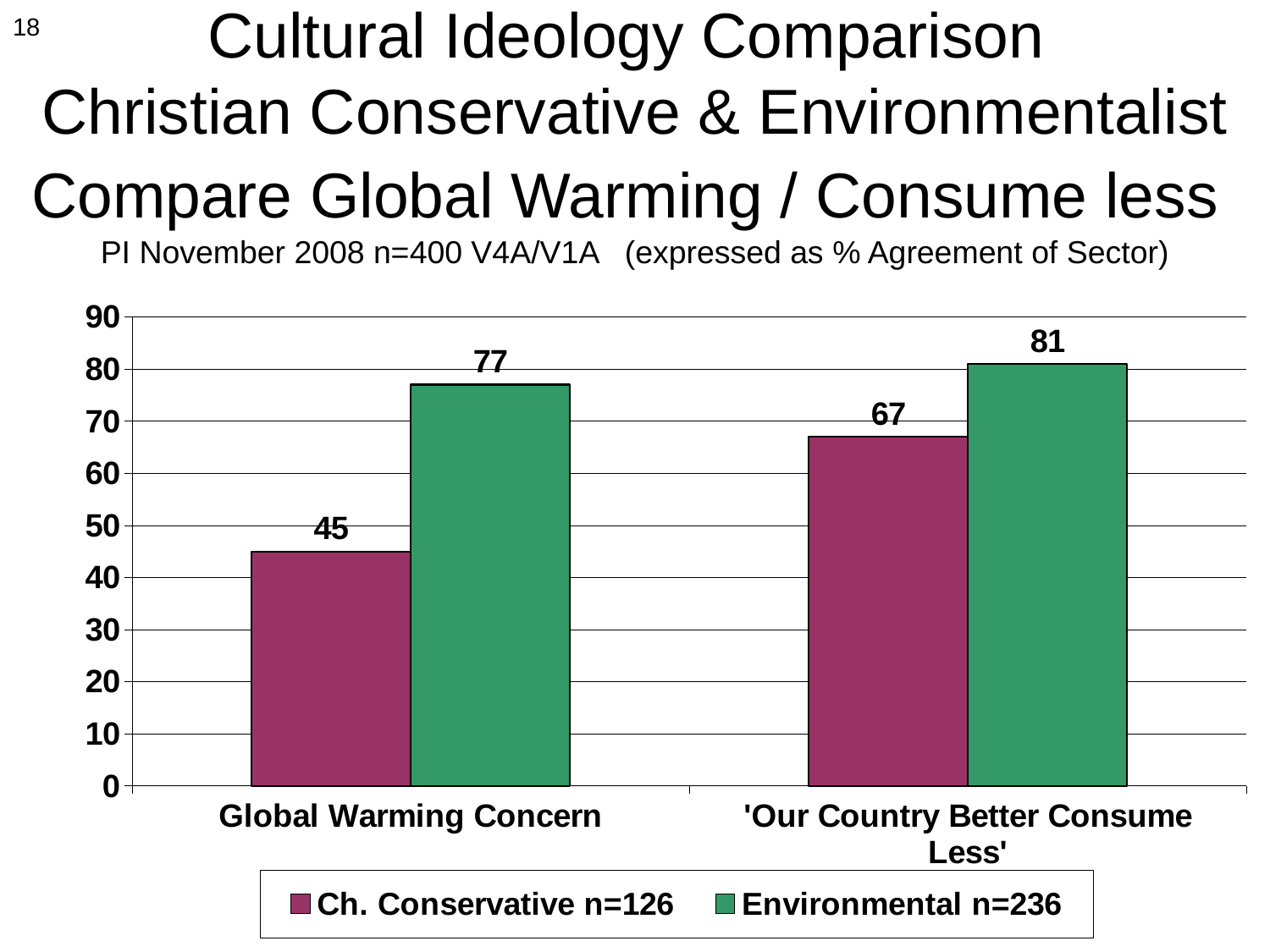
How many series does the legend list? 2 What is the value for Environmental n=236 on Global Warming Concern? 77 What is the value for Ch. Conservative n=126 on Global Warming Concern? 45 Which category has the highest value for the Environmental n=236 series? 'Our Country Better Consume Less' What is the difference between the Environmental n=236 and Ch. Conservative n=126 values on 'Our Country Better Consume Less'? 14 What is the difference between the Environmental n=236 and Ch. Conservative n=126 values on Global Warming Concern? 32 Which category has the lowest value for the Ch. Conservative n=126 series? Global Warming Concern What is the value for Ch. Conservative n=126 on 'Our Country Better Consume Less'? 67 What kind of chart is shown on the slide? Bar chart Which series has the larger value on 'Our Country Better Consume Less'? Environmental n=236 What is the value for Environmental n=236 on 'Our Country Better Consume Less'? 81 How many categories are shown on the x axis? 2